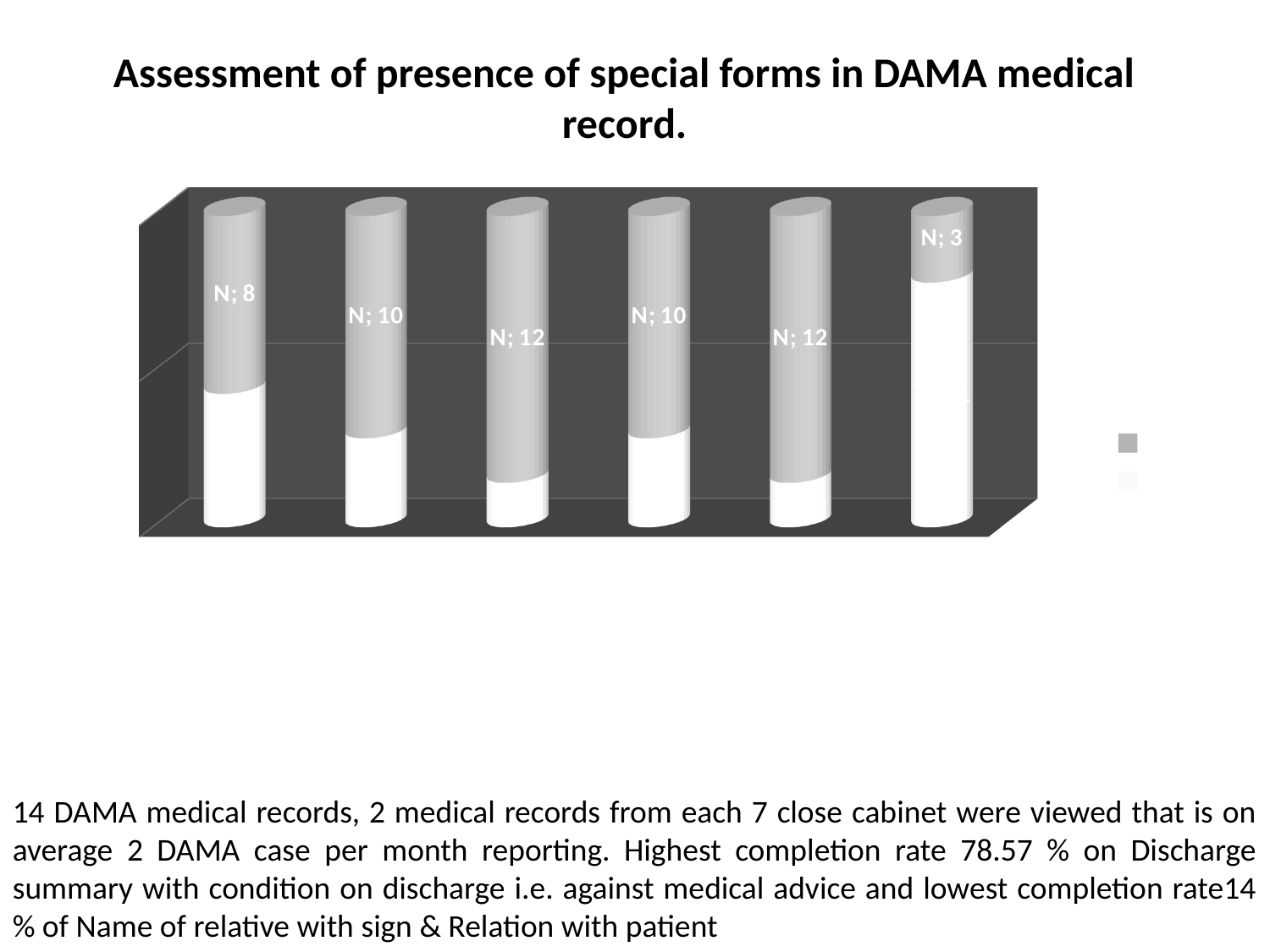
What value is labelled on the grey segment of the third bar from the left? 12 What data label is printed on the grey segment of the leftmost bar? N; 8 What is the title of the chart on the slide? Assessment of presence of special forms in DAMA medical record. What kind of chart is shown on the slide? bar chart How many entries does the chart's legend show? 2 How many bars are plotted in the chart? 6 What is the difference between the labelled grey-segment values of the leftmost bar and the rightmost bar? 5 What is the highest value labelled on any grey segment in the chart? 12 What value is labelled on the grey segment of the second bar from the left? 10 Which has the larger labelled grey-segment value, the leftmost bar or the second bar from the left? the second bar from the left What value is labelled on the grey segment of the rightmost bar? 3 Which bar has the lowest labelled grey-segment value? the rightmost bar